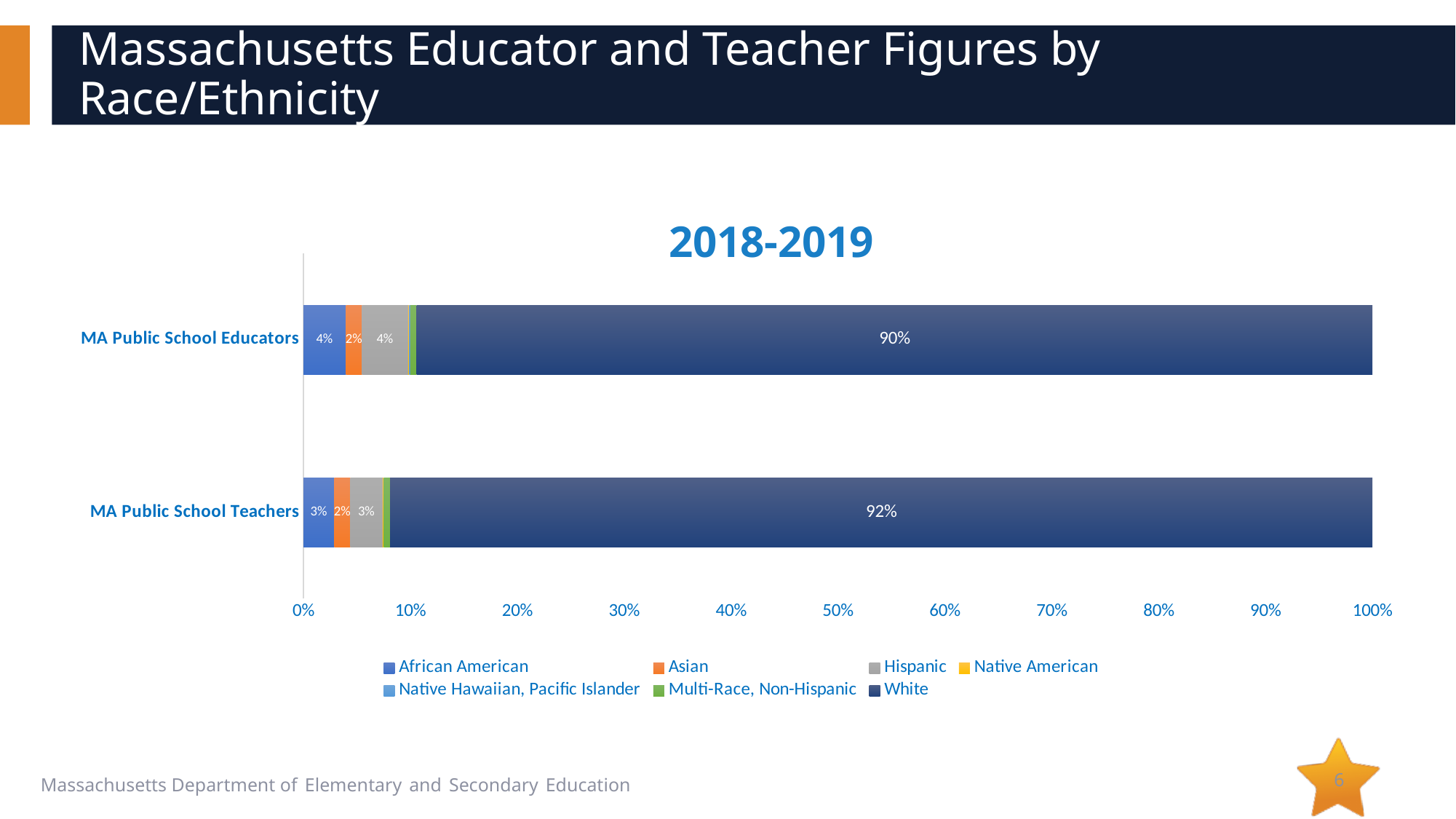
What is the title of the chart? 2018-2019 What is the Hispanic share for MA Public School Teachers? 3% How many categories (bars) are shown in the chart? 2 Which category has the higher White share, MA Public School Educators or MA Public School Teachers? MA Public School Teachers What is the White share for MA Public School Educators? 90% What is the Asian share for MA Public School Teachers? 2% What is the White share for MA Public School Teachers? 92% How many series does the legend list? 7 What kind of chart is shown on the slide? Stacked bar chart What is the difference between the White share for MA Public School Teachers and for MA Public School Educators? 2% Which series has the largest share in the MA Public School Educators bar? White What is the African American share for MA Public School Educators? 4%